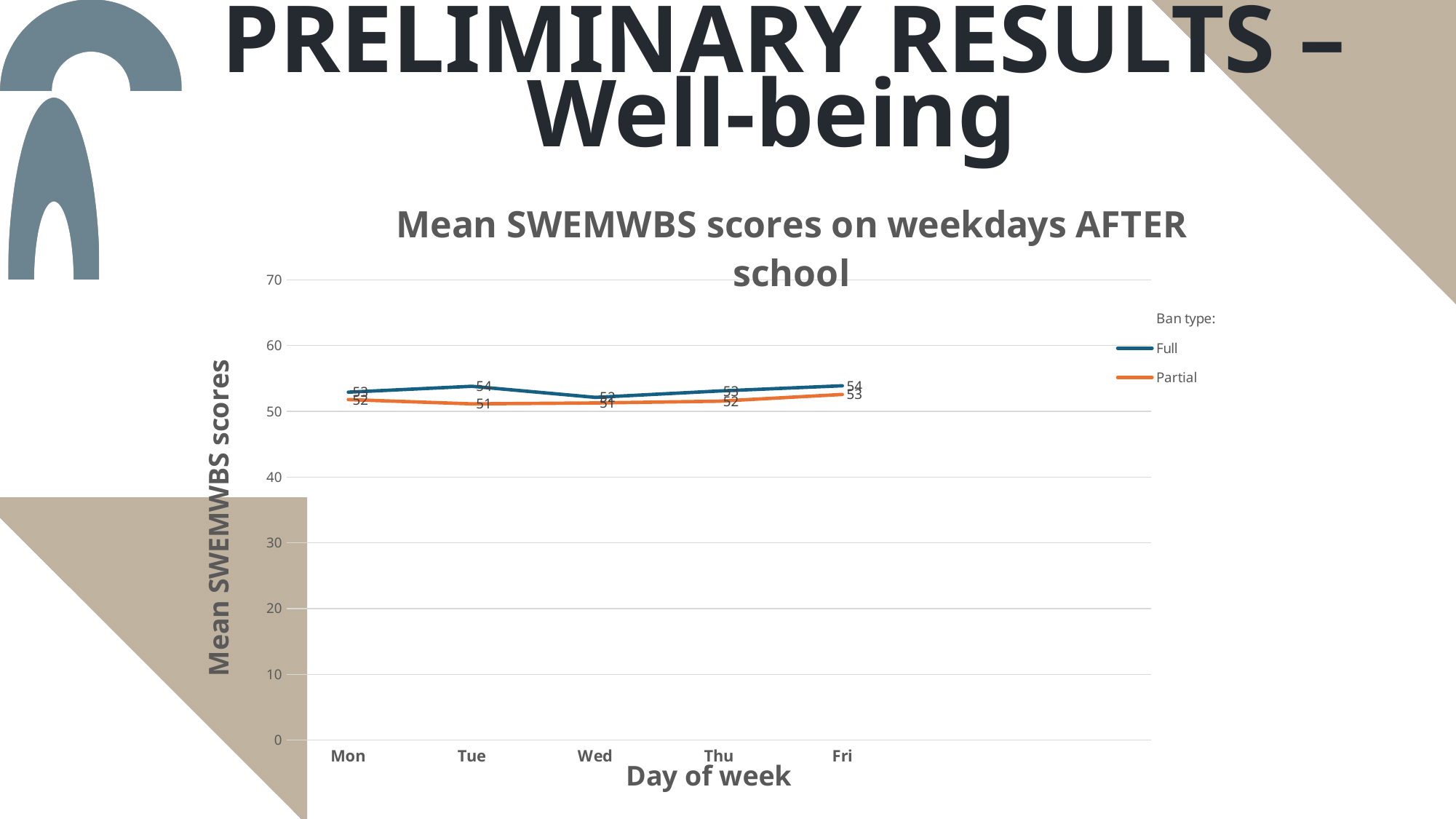
Which ban type has the higher score on Thu, Full or Partial? Full What is the difference between the Full and Partial scores on Tue? 3 How many series does the legend list? 2 What is the title of the chart? Mean SWEMWBS scores on weekdays AFTER school How many days of the week are plotted on the x axis? 5 What is the mean SWEMWBS score for the Partial ban type on Fri? 53 What is the mean SWEMWBS score for the Partial ban type on Wed? 51 What is the mean SWEMWBS score for the Full ban type on Tue? 54 Is the Full ban type score on Fri greater or less than 60? less What is the mean SWEMWBS score for the Full ban type on Wed? 52 What type of chart is shown on the slide? line chart What is the label of the y axis? Mean SWEMWBS scores